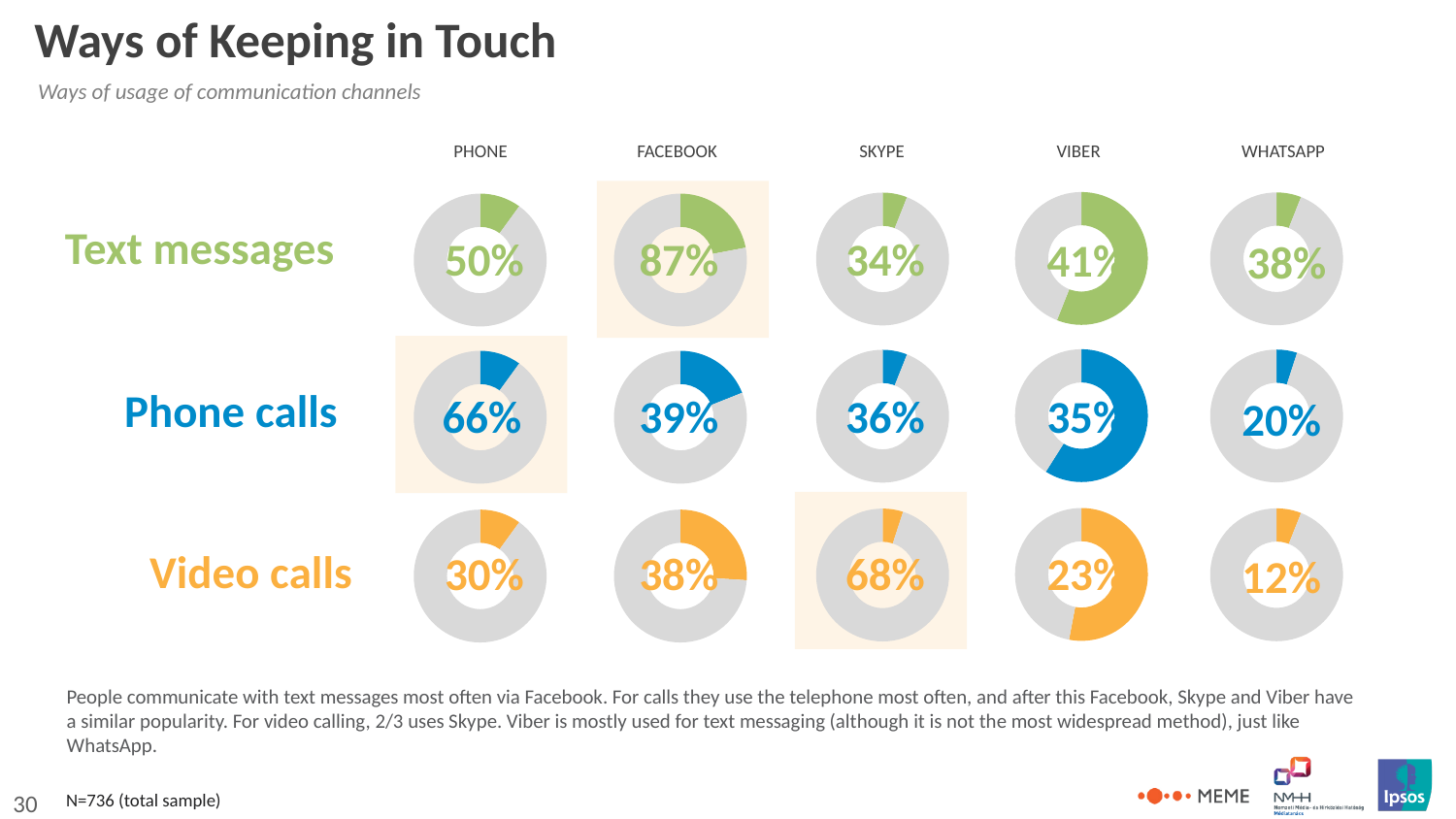
In the Video calls row, what percentage is shown for Skype? 68% What colour is used for the Video calls row of donut charts? Orange In the Phone calls row, which is larger: the value for Facebook or the value for WhatsApp? Facebook In the Text messages row, what percentage is shown for Facebook? 87% In the Phone calls row, what percentage is shown for Phone? 66% In the Video calls row, what percentage is shown for WhatsApp? 12% What type of chart is used to show each percentage on the slide? Donut chart What is the difference between the Text messages percentage for Facebook and for Phone? 37% In the Phone calls row, which channel has the lowest percentage? WhatsApp How many communication channels are shown as columns of donut charts? 5 In the Text messages row, which channel has the highest percentage? Facebook In the Video calls row, which channel has the highest percentage? Skype